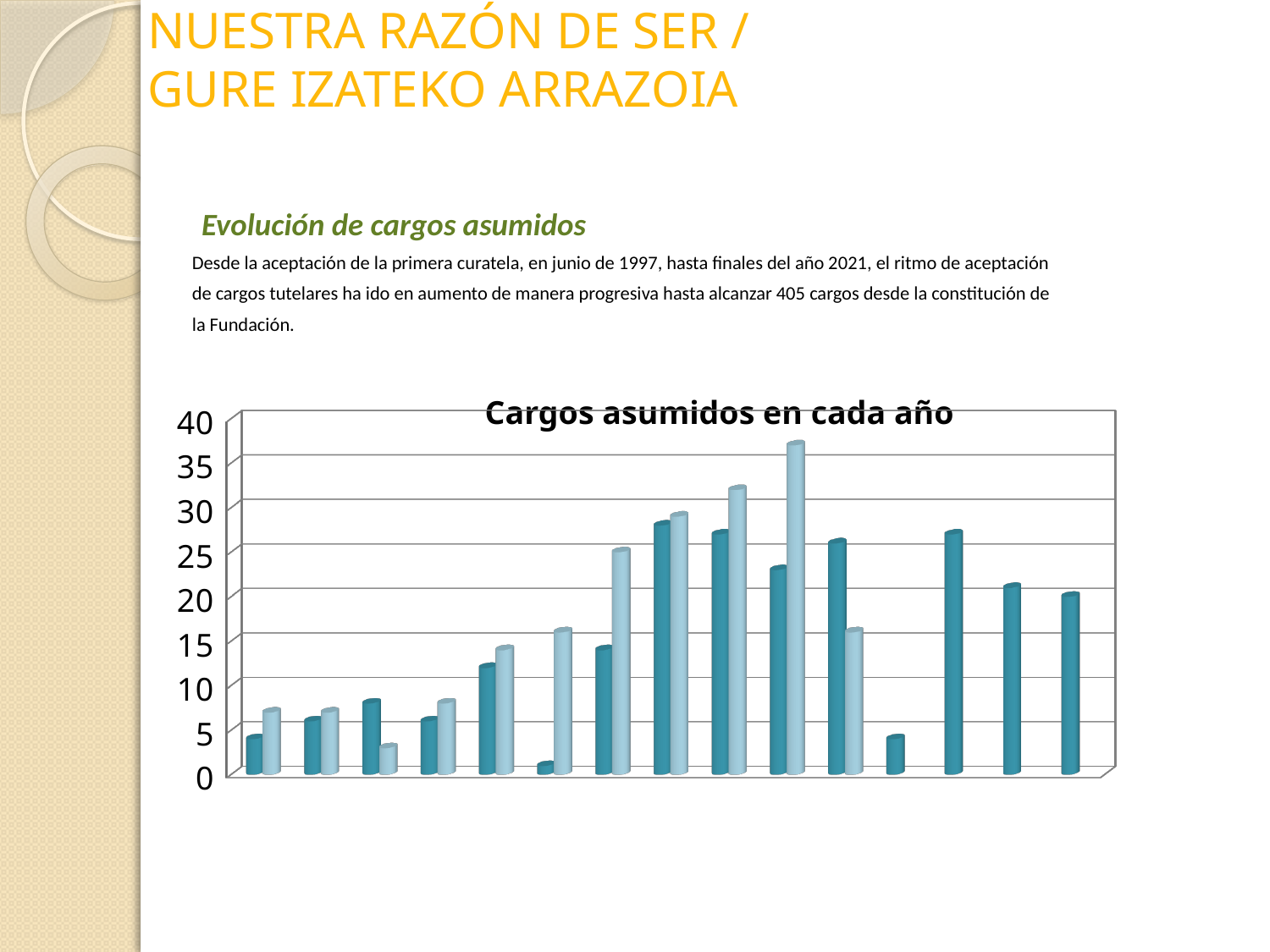
Is the shortest bar in the chart greater or less than 5? less How many groups of bars are plotted along the horizontal axis? 15 What is the title of the chart? Cargos asumidos en cada año How many different bar colours are used in the chart? 2 What is the highest value labelled on the vertical axis of the chart? 40 What kind of chart is shown on the slide? bar chart Is the tallest bar in the chart greater or less than 35? greater Is the tallest dark teal bar in the chart greater or less than 25? greater